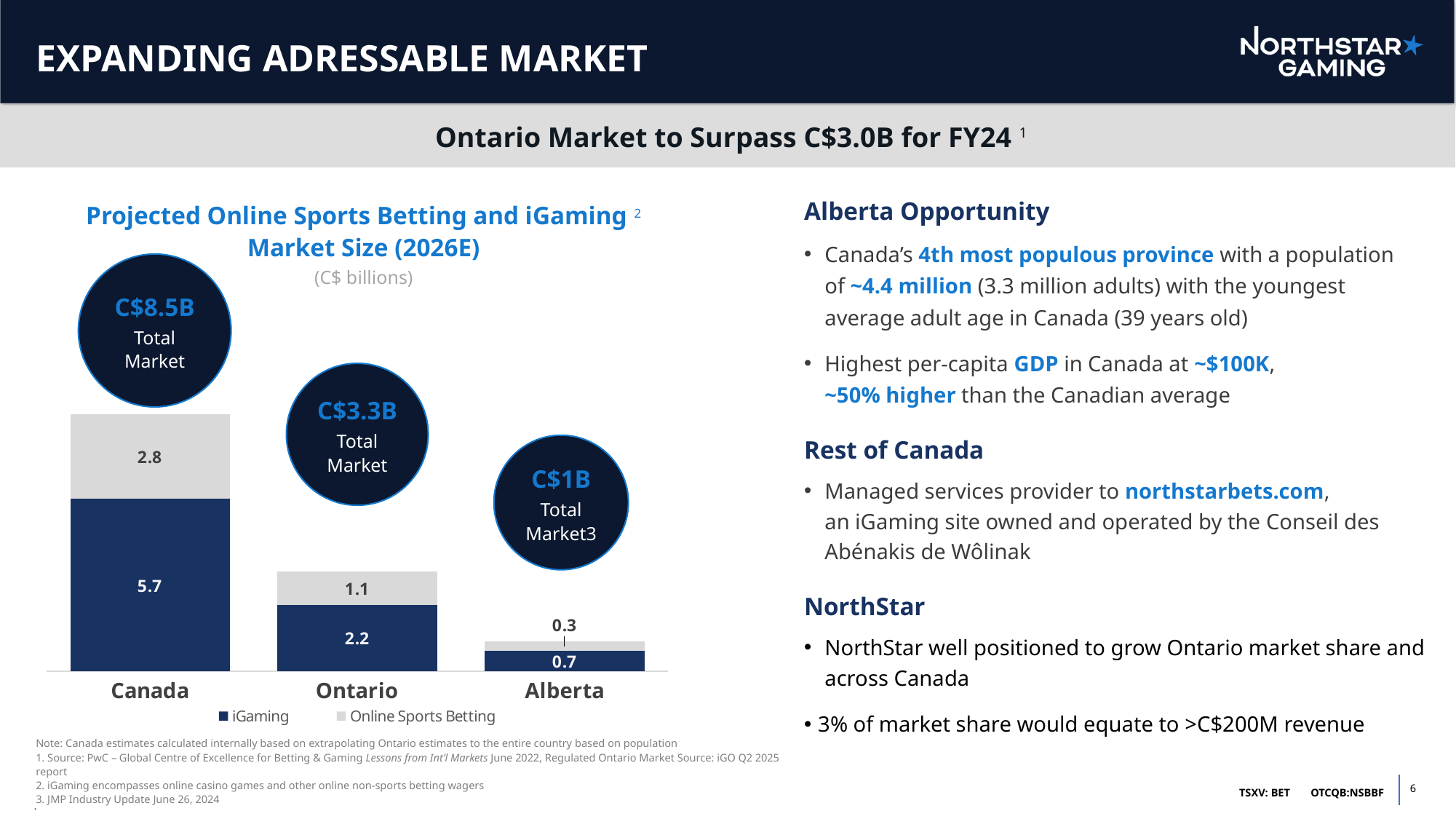
What is the Online Sports Betting value for Ontario? 1.1 Which category has the lowest Online Sports Betting value? Alberta What is the iGaming value for Alberta? 0.7 How many series does the legend list? 2 What kind of chart is shown? Stacked bar chart What is the Online Sports Betting value for Canada? 2.8 Which category has the highest iGaming value? Canada How many categories are shown on the x axis? 3 Which is larger, the iGaming value for Ontario or the Online Sports Betting value for Ontario? iGaming What is the iGaming value for Canada? 5.7 What is the difference between the iGaming values for Canada and Ontario? 3.5 What is the total market value shown for Ontario? C$3.3B